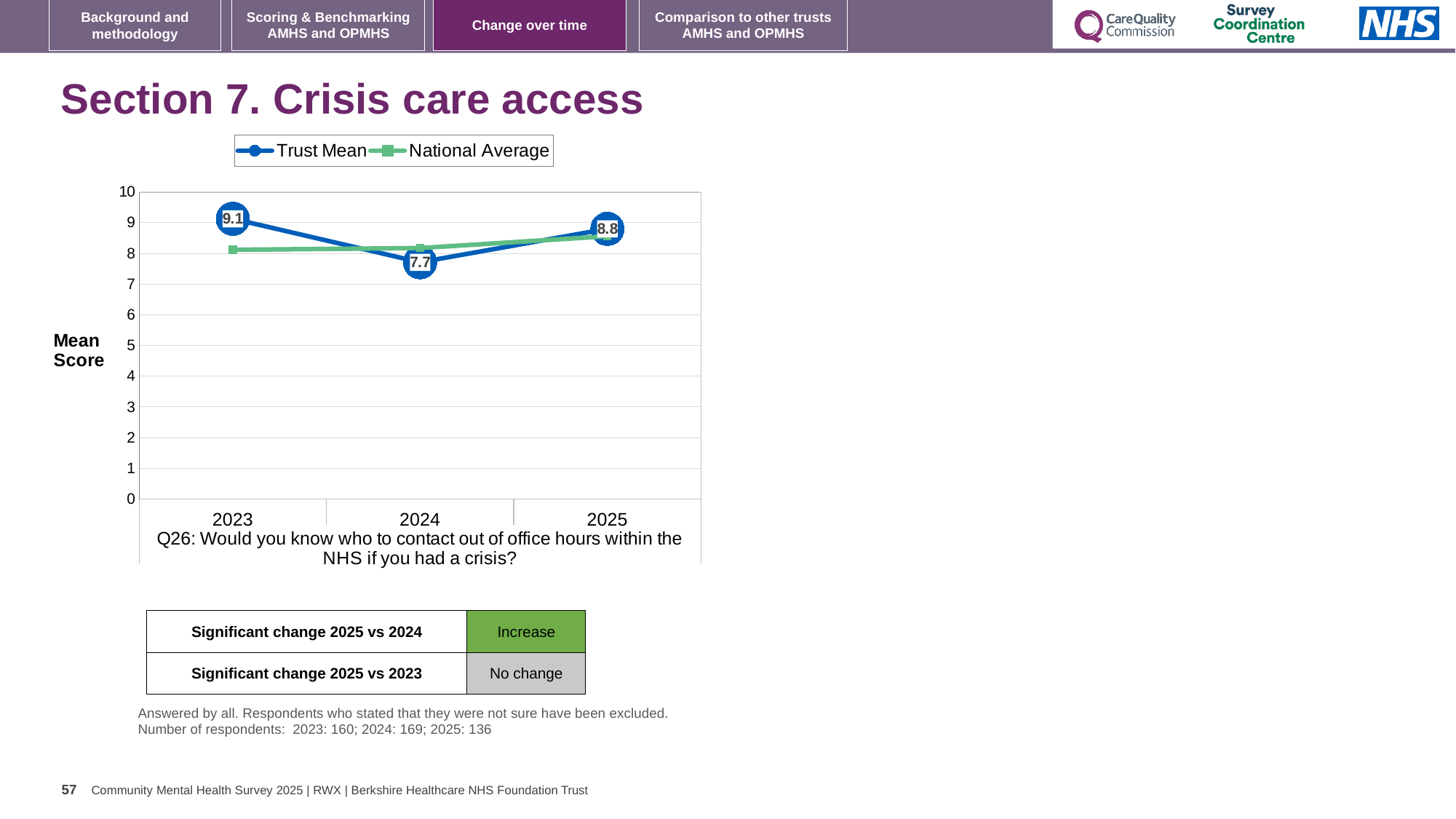
How many series does the legend list? 2 Is the National Average value for 2025 greater or less than 9? less In 2024, which series has the higher value, Trust Mean or National Average? National Average Which is larger, the Trust Mean in 2023 or the Trust Mean in 2025? 2023 What is the difference between the Trust Mean in 2023 and in 2024? 1.4 In which year is the Trust Mean lowest? 2024 What is the Trust Mean value for 2024? 7.7 How many years are shown on the x axis? 3 What is the Trust Mean value for 2025? 8.8 What is the Trust Mean value for 2023? 9.1 In which year is the Trust Mean highest? 2023 What kind of chart is shown on the slide? Line chart